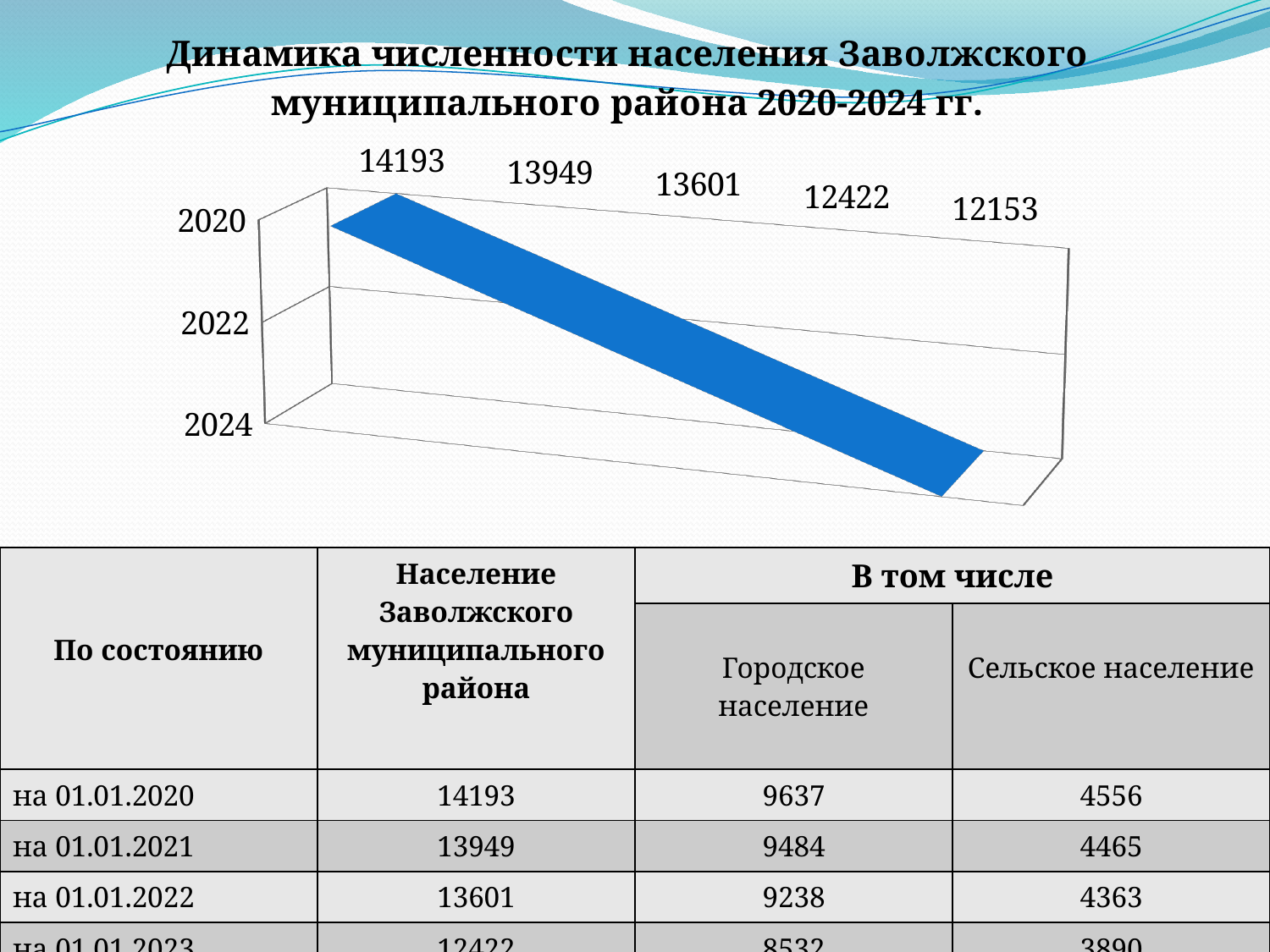
What is the difference between the population values for 2022 and 2023 on the chart? 1179 What is the population value shown for 2024 on the chart? 12153 Which is larger on the chart, the value for 2021 or the value for 2023? 2021 What is the population value shown for 2021 on the chart? 13949 Do the population values rise or fall from 2020 to 2024 on the chart? fall What is the title of the chart on the slide? Динамика численности населения Заволжского муниципального района 2020-2024 гг. Which year has the highest population value on the chart? 2020 How many data points are plotted on the chart? 5 Which year has the lowest population value on the chart? 2024 What is the population value shown for 2022 on the chart? 13601 What is the population value shown for 2020 on the chart? 14193 What is the difference between the population values for 2020 and 2024 on the chart? 2040